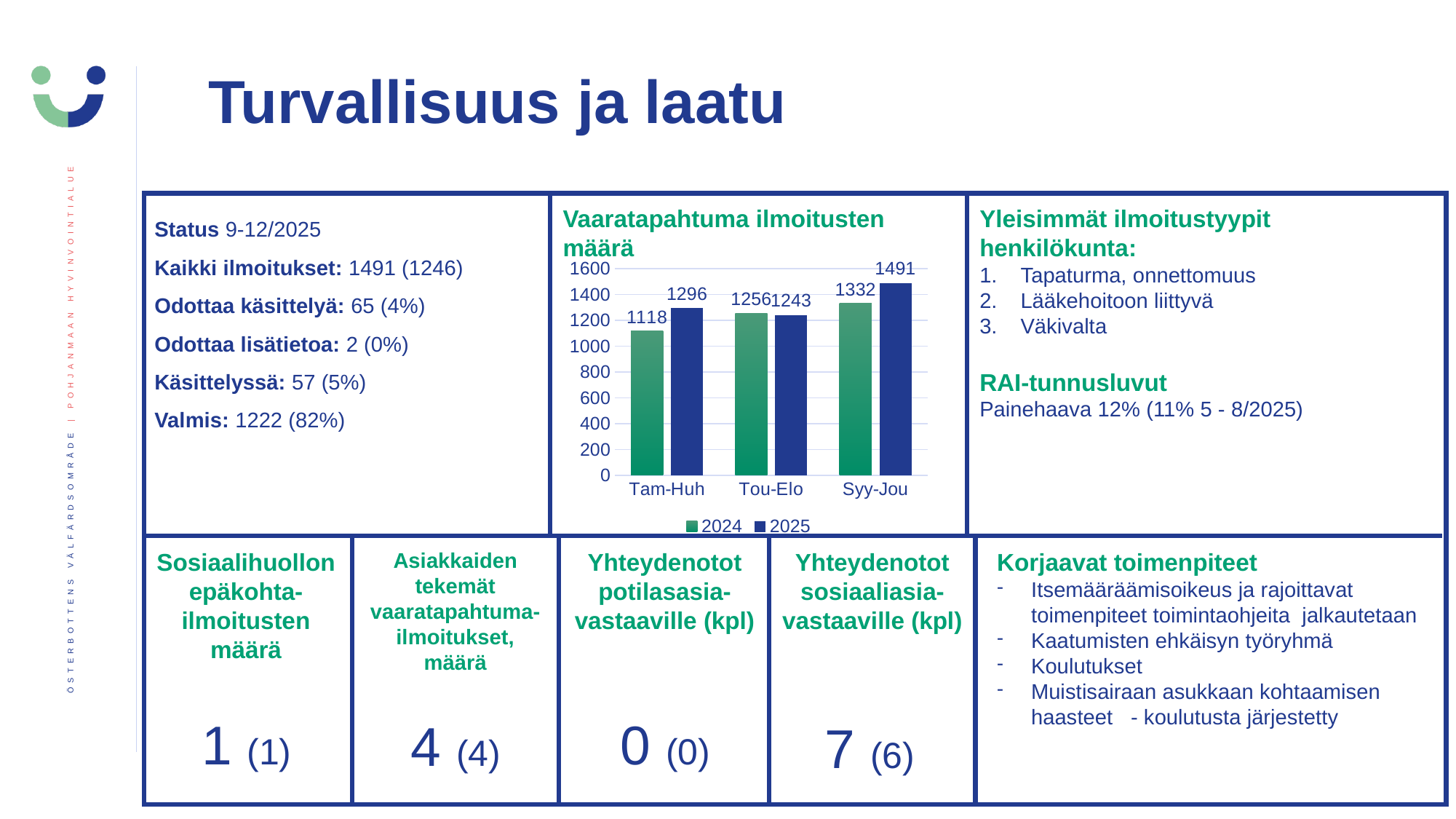
What type of chart is shown under the title "Vaaratapahtuma ilmoitusten määrä"? bar chart How many categories are shown on the x axis of the "Vaaratapahtuma ilmoitusten määrä" chart? 3 In the "Vaaratapahtuma ilmoitusten määrä" chart, do the 2024 values rise or fall from Tam-Huh to Syy-Jou? rise In the "Vaaratapahtuma ilmoitusten määrä" chart, what is the 2024 value for Tam-Huh? 1118 In the "Vaaratapahtuma ilmoitusten määrä" chart, which is larger for Tou-Elo: the 2024 value or the 2025 value? 2024 In the "Vaaratapahtuma ilmoitusten määrä" chart, what is the 2025 value for Tou-Elo? 1243 In the "Vaaratapahtuma ilmoitusten määrä" chart, which category has the highest 2025 value? Syy-Jou In the "Vaaratapahtuma ilmoitusten määrä" chart, which colour represents the 2025 series? blue In the "Vaaratapahtuma ilmoitusten määrä" chart, what is the 2025 value for Syy-Jou? 1491 In the "Vaaratapahtuma ilmoitusten määrä" chart, which category has the lowest 2024 value? Tam-Huh How many series does the legend of the "Vaaratapahtuma ilmoitusten määrä" chart list? 2 In the "Vaaratapahtuma ilmoitusten määrä" chart, what is the difference between the 2025 and 2024 values for Syy-Jou? 159